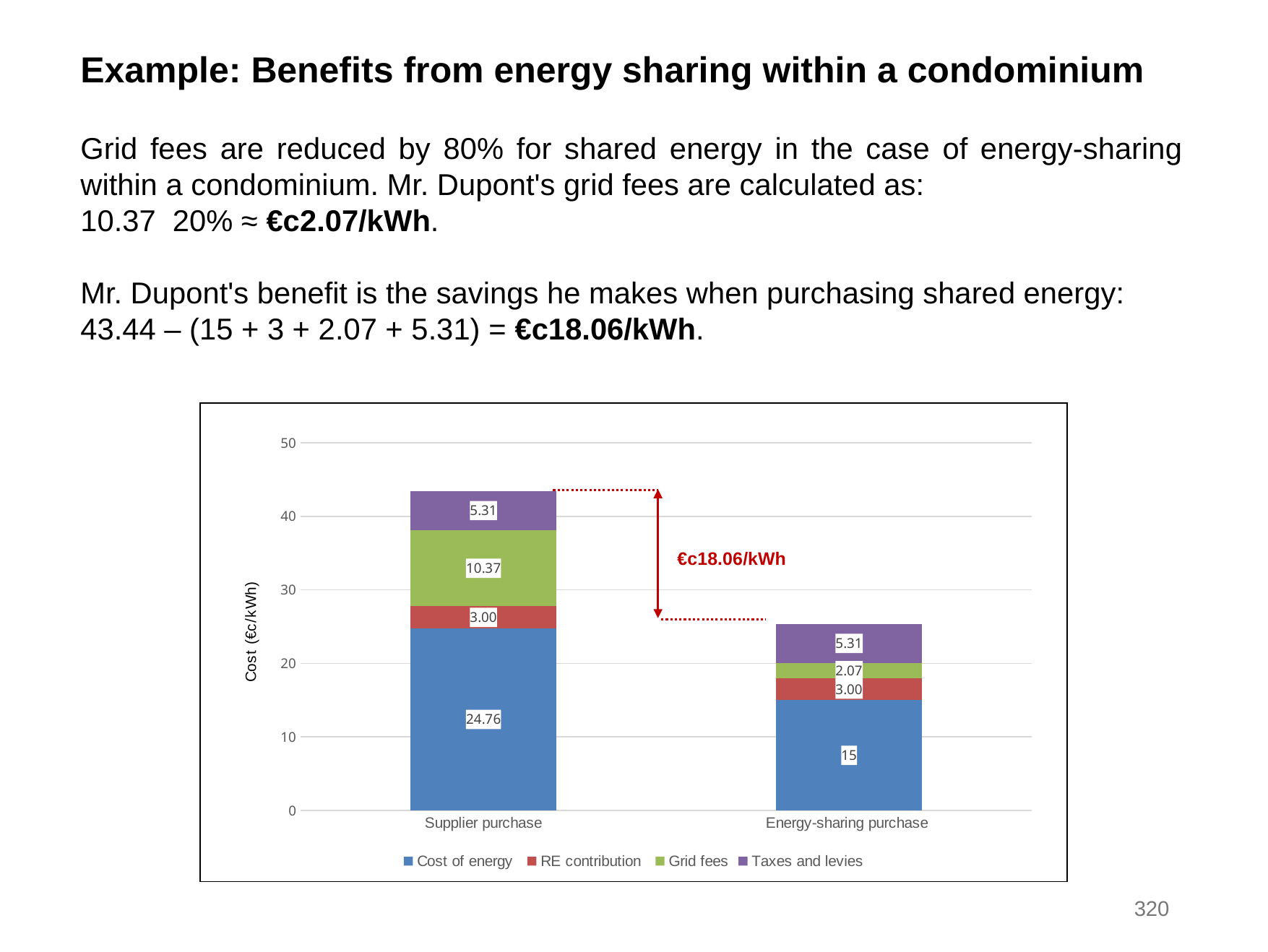
What is the Grid fees value for Energy-sharing purchase? 2.07 What is the Taxes and levies value for Energy-sharing purchase? 5.31 What is the difference in Grid fees between Supplier purchase and Energy-sharing purchase? 8.30 Which category has the larger Cost of energy, Supplier purchase or Energy-sharing purchase? Supplier purchase What is the label on the y axis of the chart? Cost (€c/kWh) What is the Grid fees value for Supplier purchase? 10.37 What is the Cost of energy value for Supplier purchase? 24.76 What is the total of the stacked bar for Energy-sharing purchase? 25.38 How many series does the legend list? 4 What is the difference in Cost of energy between Supplier purchase and Energy-sharing purchase? 9.76 What kind of chart is shown on the slide? Stacked bar chart Is the total for Supplier purchase greater or less than 40? greater